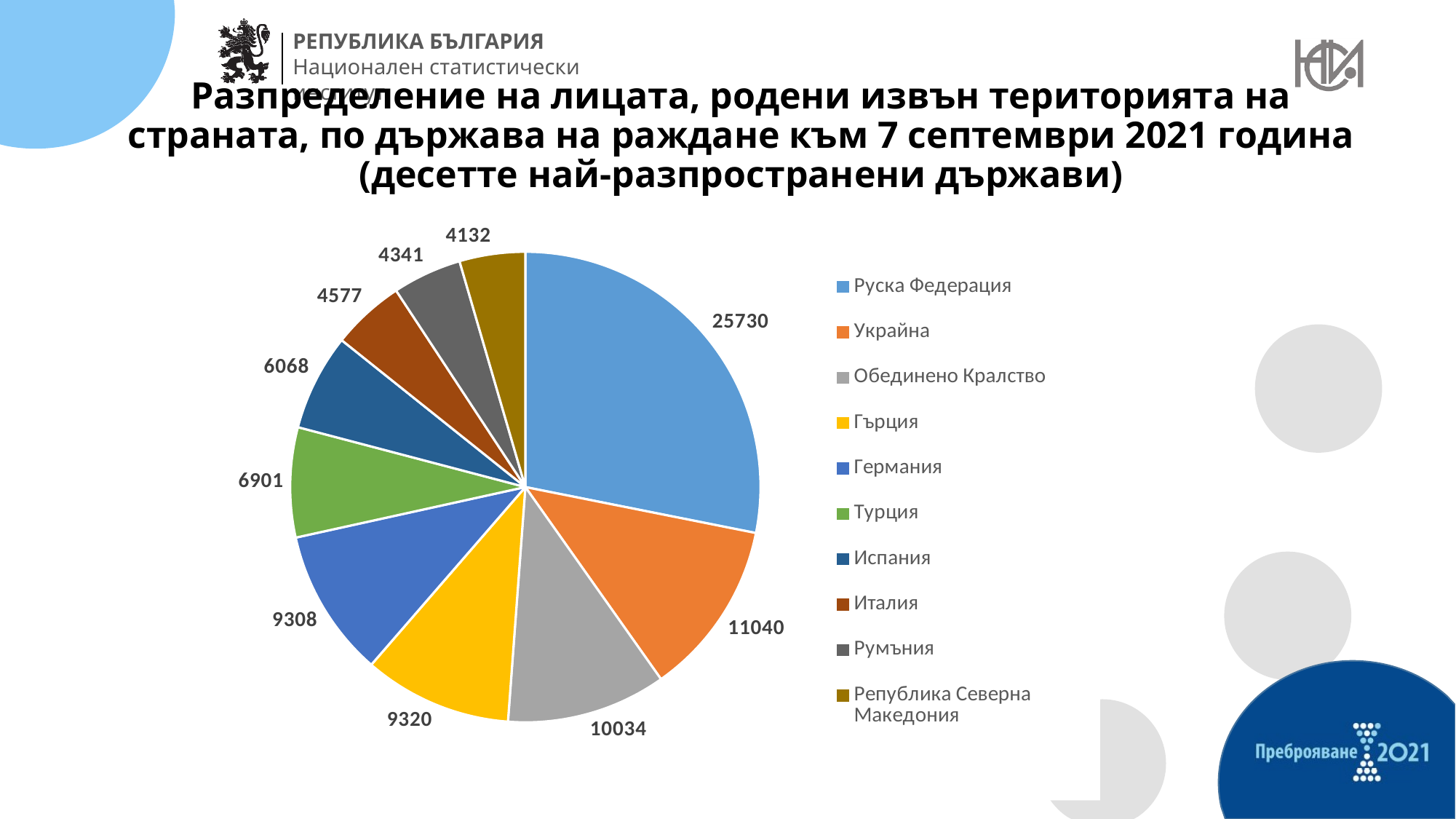
What is the value for Украйна? 11040 What type of chart is shown on the slide? pie chart What is the value for Република Северна Македония? 4132 What is the value for Обединено Кралство? 10034 Which country has the largest slice in the pie chart? Руска Федерация How many countries (slices) does the pie chart show? 10 Which colour represents Италия in the pie chart? dark brown/red Which country has the smallest slice in the pie chart? Република Северна Македония What is the difference between the values for Гърция and Германия? 12 What is the difference between the values for Украйна and Обединено Кралство? 1006 What is the value for Руска Федерация? 25730 Which is larger, the value for Турция or the value for Испания? Турция